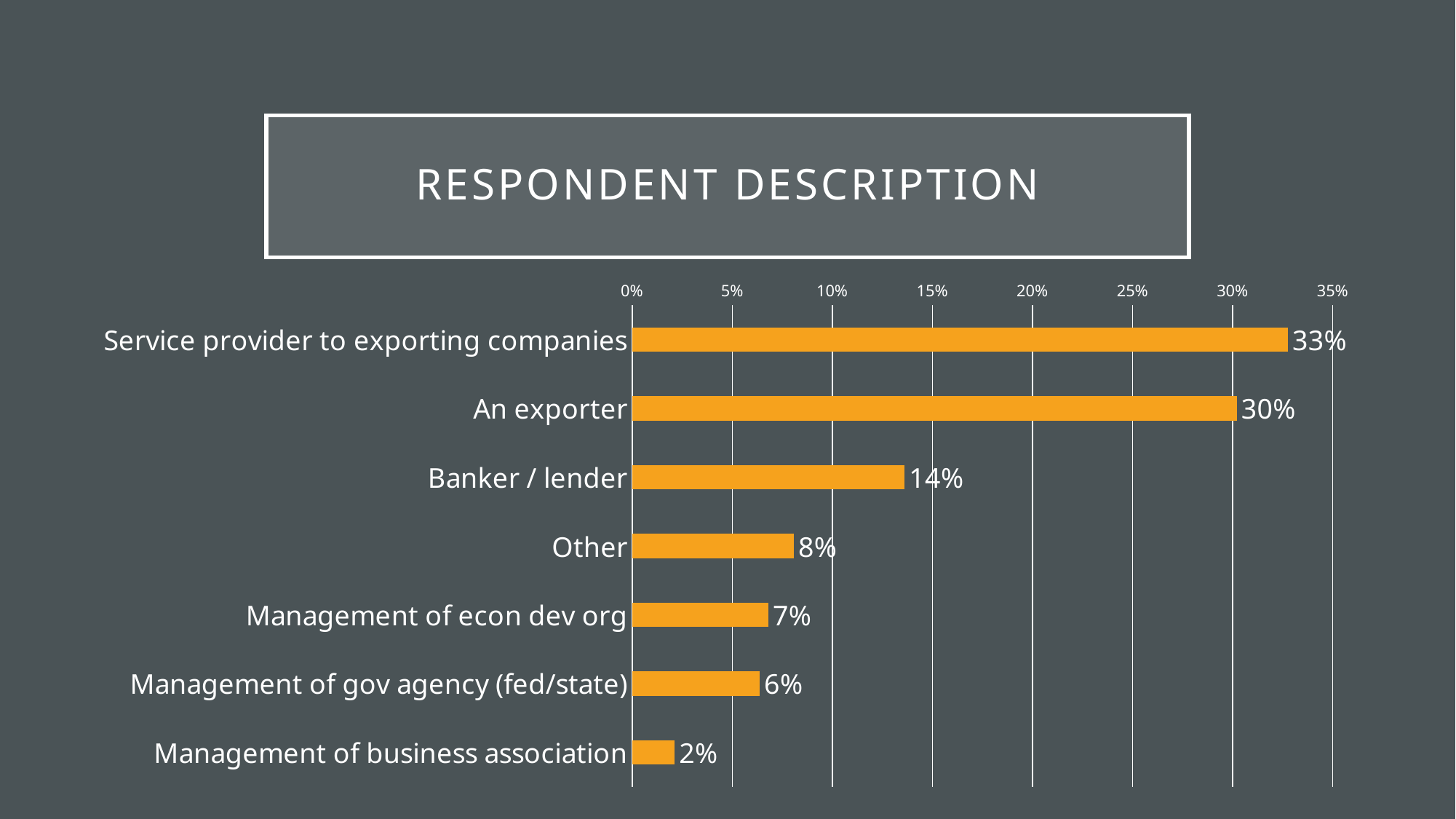
What is the difference between the percentages for Service provider to exporting companies and An exporter? 3% Which respondent category has the lowest percentage? Management of business association How many respondent categories are shown in the chart? 7 What kind of chart is shown on the slide? Bar chart What percentage of respondents are bankers / lenders? 14% Which is larger, the value for Management of econ dev org or the value for Management of gov agency (fed/state)? Management of econ dev org What is the title of the slide? RESPONDENT DESCRIPTION What is the difference between the percentages for Banker / lender and Other? 6% What percentage of respondents are service providers to exporting companies? 33% What is the value for Management of business association? 2% Which respondent category has the highest percentage? Service provider to exporting companies Is the value for An exporter greater or less than 25%? greater